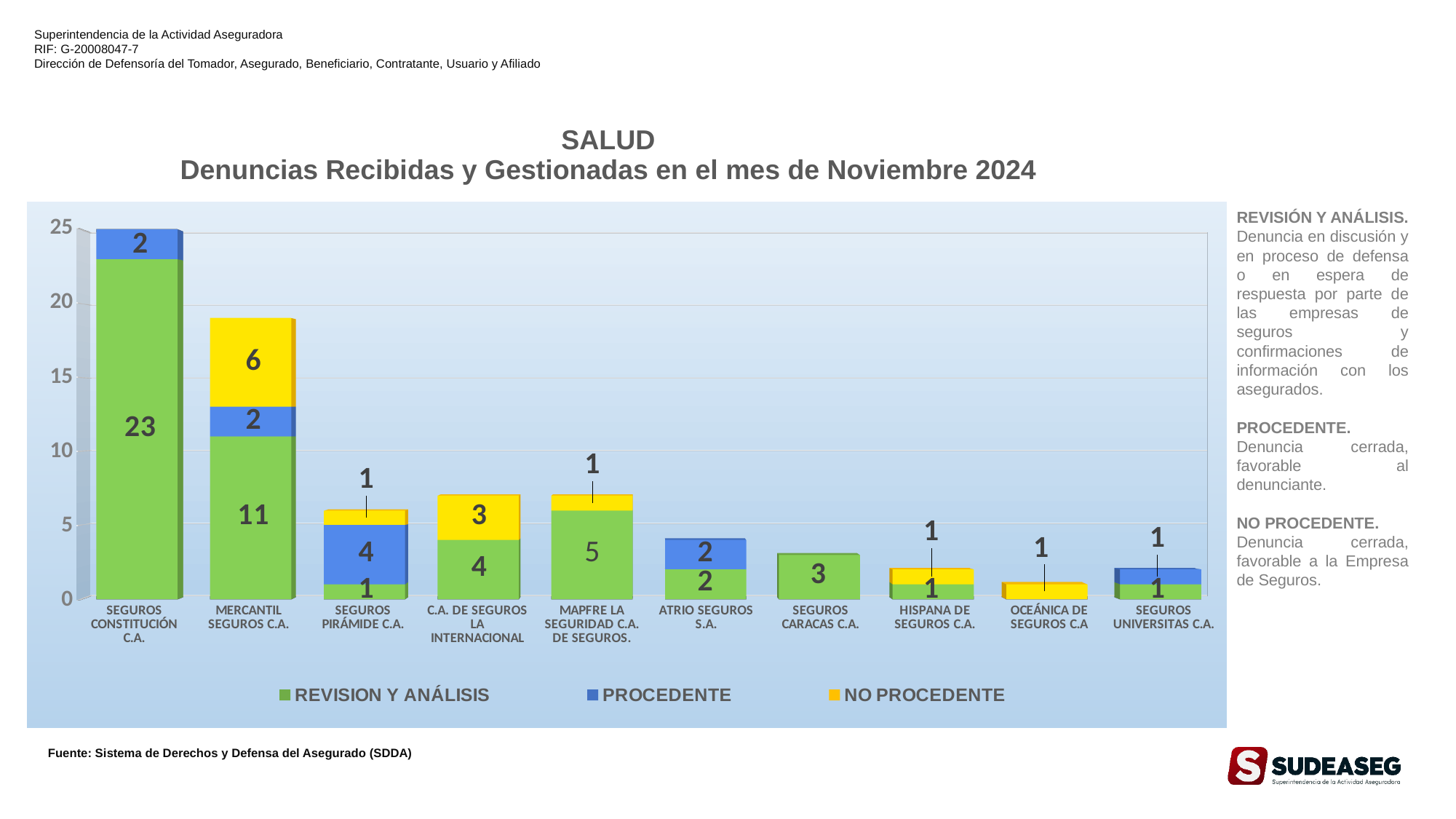
What is the PROCEDENTE value for SEGUROS PIRÁMIDE C.A.? 4 What is the NO PROCEDENTE value for MERCANTIL SEGUROS C.A.? 6 Which is larger: the REVISION Y ANÁLISIS value for MAPFRE LA SEGURIDAD C.A. DE SEGUROS. or for SEGUROS CARACAS C.A.? MAPFRE LA SEGURIDAD C.A. DE SEGUROS. What is the total of the stacked bar for MERCANTIL SEGUROS C.A.? 19 What is the difference between the REVISION Y ANÁLISIS values of SEGUROS CONSTITUCIÓN C.A. and MERCANTIL SEGUROS C.A.? 12 How many series does the legend list? 3 What type of chart is shown on the slide? Stacked bar chart Which company has the highest total number of denuncias? SEGUROS CONSTITUCIÓN C.A. Which company has the lowest total number of denuncias? OCEÁNICA DE SEGUROS C.A What is the REVISION Y ANÁLISIS value for SEGUROS CONSTITUCIÓN C.A.? 23 Which colour represents the NO PROCEDENTE series in the legend? Yellow How many insurance companies (categories) are shown on the x axis? 10